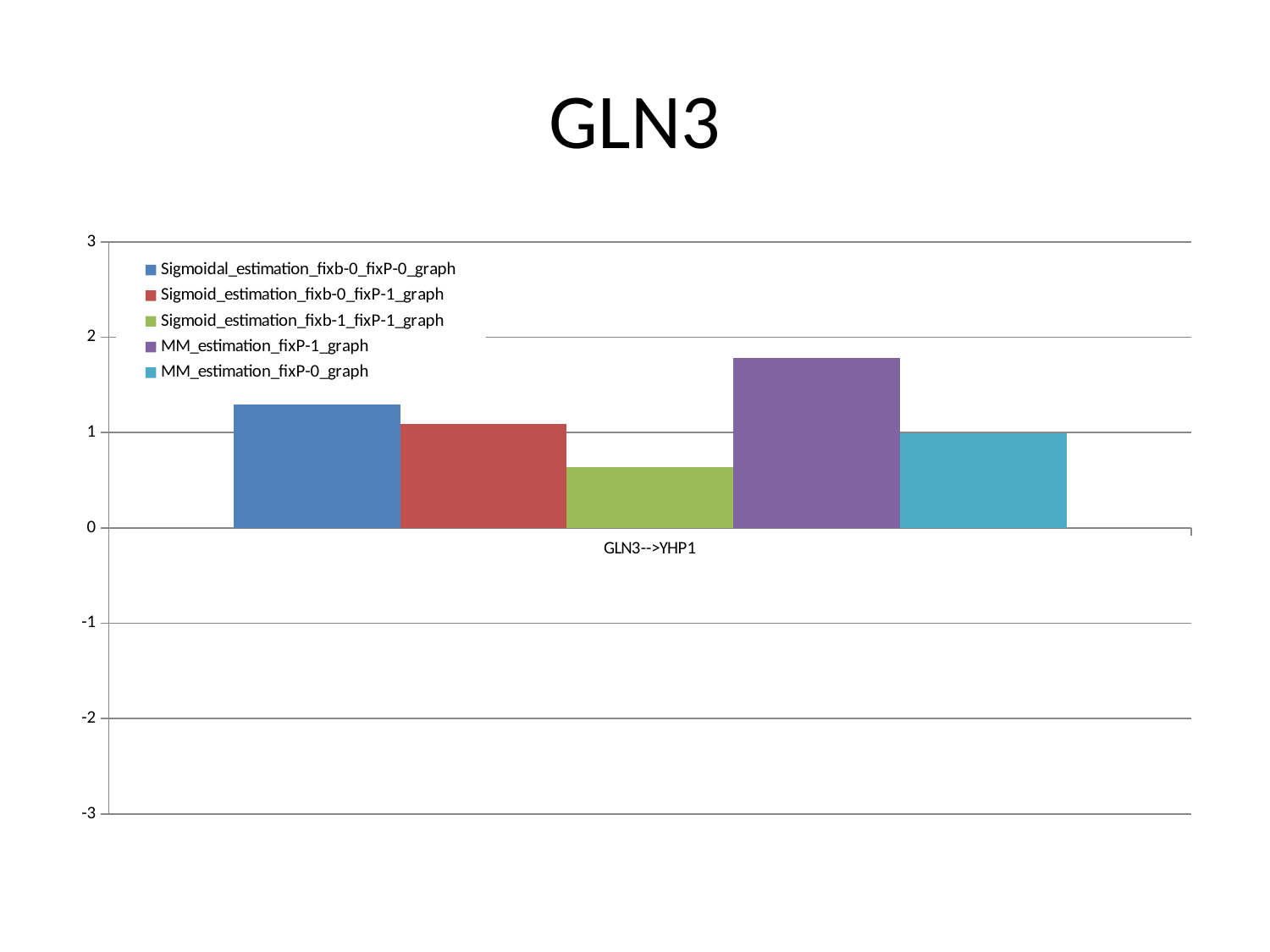
Which series has the highest value for GLN3-->YHP1? MM_estimation_fixP-1_graph What kind of chart is shown on the slide? bar chart How many series does the legend list? 5 Is the value for Sigmoidal_estimation_fixb-0_fixP-0_graph greater or less than 1? greater How many categories are shown on the x axis? 1 Which series has the lowest value for GLN3-->YHP1? Sigmoid_estimation_fixb-1_fixP-1_graph Is the value for Sigmoid_estimation_fixb-1_fixP-1_graph greater or less than 1? less What is the title of the slide above the chart? GLN3 Which is larger, the value for Sigmoidal_estimation_fixb-0_fixP-0_graph or the value for Sigmoid_estimation_fixb-1_fixP-1_graph? Sigmoidal_estimation_fixb-0_fixP-0_graph Which is larger, the value for MM_estimation_fixP-1_graph or the value for Sigmoidal_estimation_fixb-0_fixP-0_graph? MM_estimation_fixP-1_graph Is the value for MM_estimation_fixP-1_graph greater or less than 2? less What is the category label on the x axis? GLN3-->YHP1